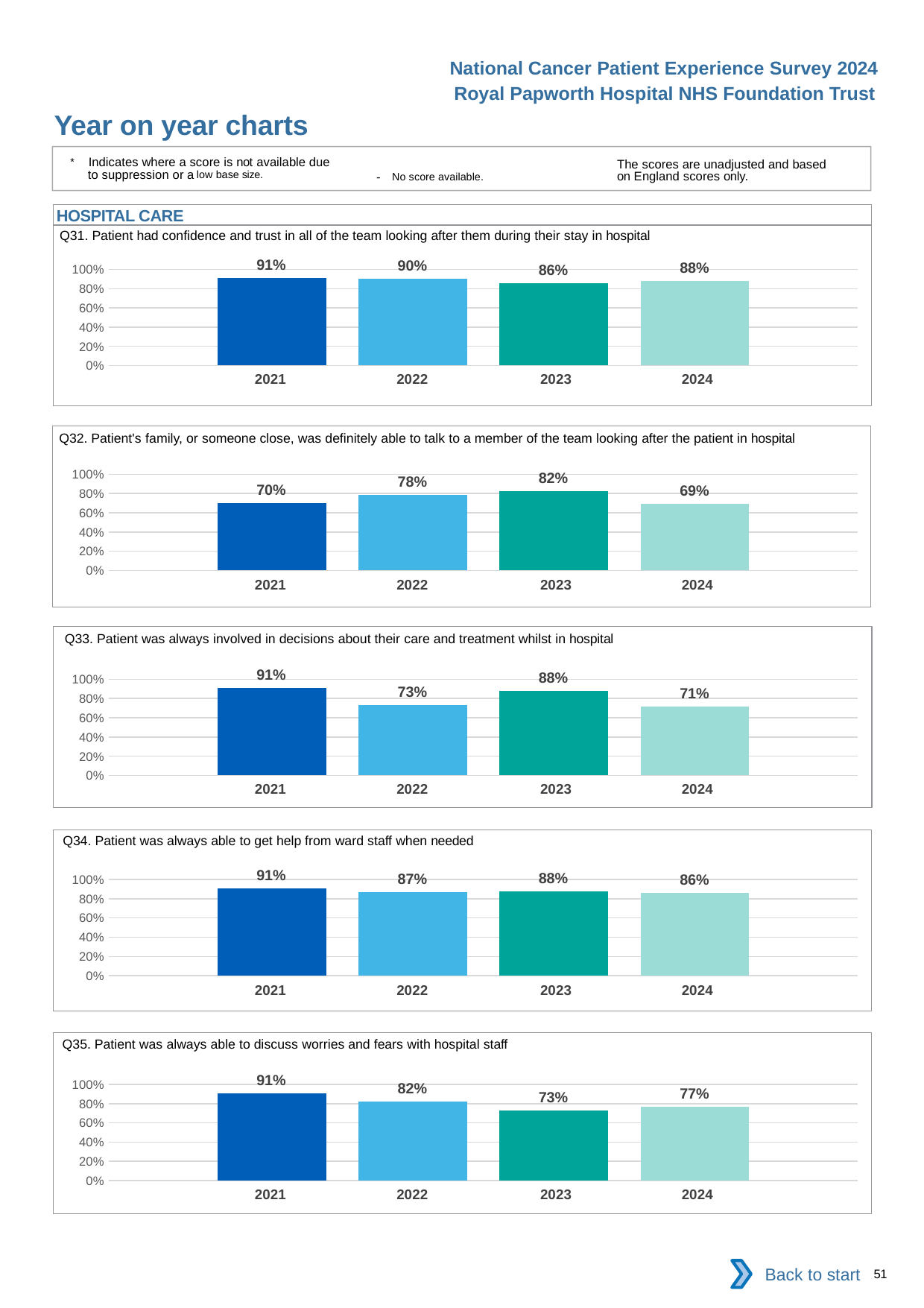
In the Q32 chart (patient's family was definitely able to talk to a member of the team), is the value for 2021 greater or less than 80%? less In the Q33 chart (patient was always involved in decisions about their care), what is the difference between the 2021 and 2024 values? 20% In the Q32 chart (patient's family was definitely able to talk to a member of the team), which year has the highest value? 2023 In the Q33 chart (patient was always involved in decisions about their care), which is larger, the value for 2022 or the value for 2023? 2023 In the Q32 chart (patient's family was definitely able to talk to a member of the team), which year has the lowest value? 2024 In the Q34 chart (patient was always able to get help from ward staff), what is the value for 2022? 87% How many years are plotted in the Q31 chart (patient had confidence and trust in all of the team)? 4 In the Q35 chart (patient was always able to discuss worries and fears), which year has the lowest value? 2023 How many charts are shown on the slide under the HOSPITAL CARE heading? 5 What kind of chart is the Q34 chart (patient was always able to get help from ward staff)? Bar chart In the Q35 chart (patient was always able to discuss worries and fears), what is the difference between the 2021 and 2022 values? 9% In the Q31 chart (patient had confidence and trust in all of the team), what is the value for 2023? 86%